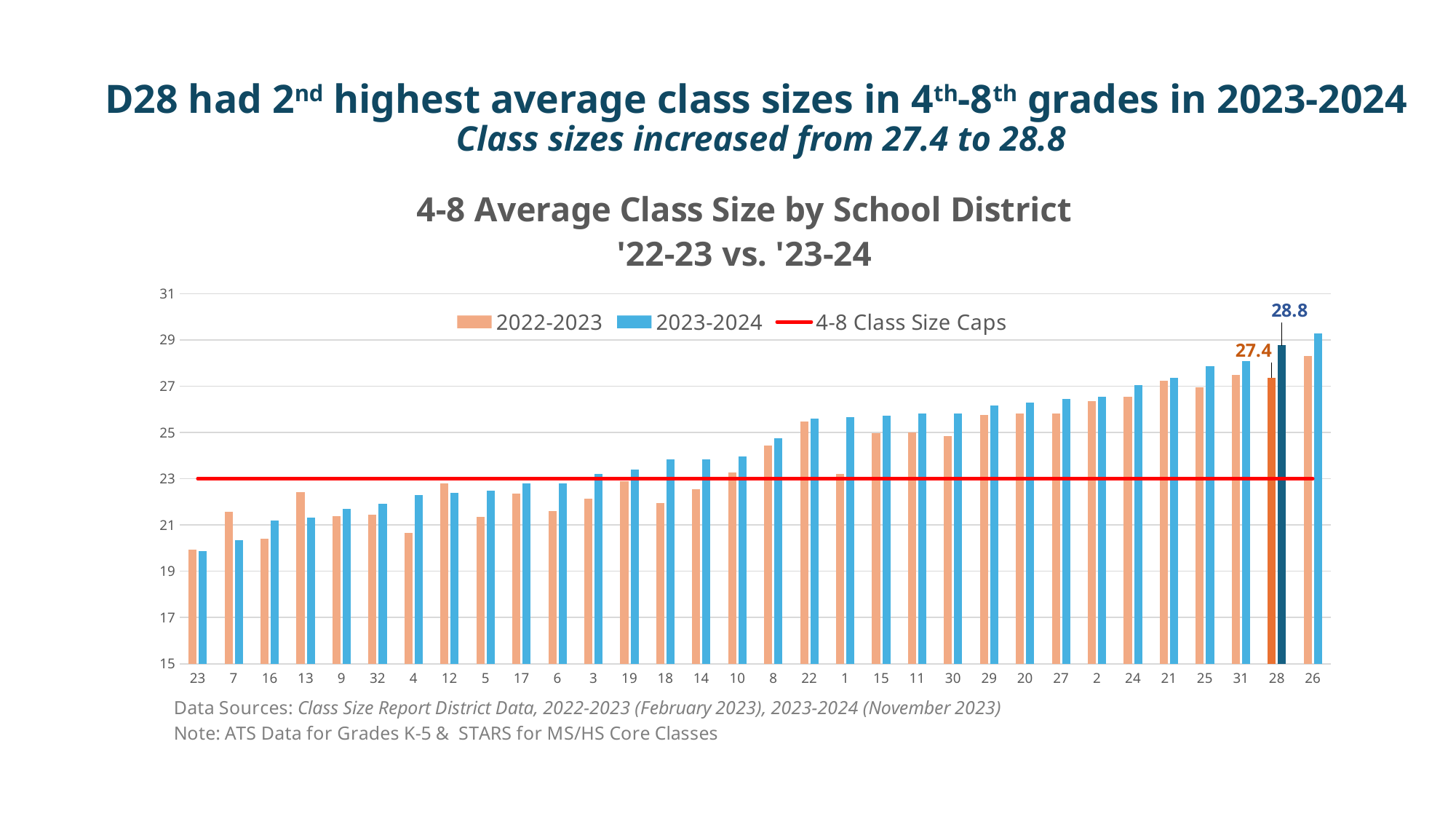
Is the 2023-2024 value for district 23 greater or less than 21? less For district 28, which is larger: the 2022-2023 value or the 2023-2024 value? 2023-2024 By how much did district 28's average class size increase from 2022-2023 to 2023-2024? 1.4 How many entries does the legend list? 3 Which district has the highest 2023-2024 average class size? 26 Which district has the lowest 2023-2024 average class size? 23 How many school districts are shown on the x axis? 32 At what value is the red 4-8 Class Size Caps line drawn? 23 What is the 2022-2023 average class size for district 28? 27.4 What kind of chart is this? Combination bar and line chart Is the 2023-2024 value for district 26 greater or less than 27? greater What is the 2023-2024 average class size for district 28? 28.8